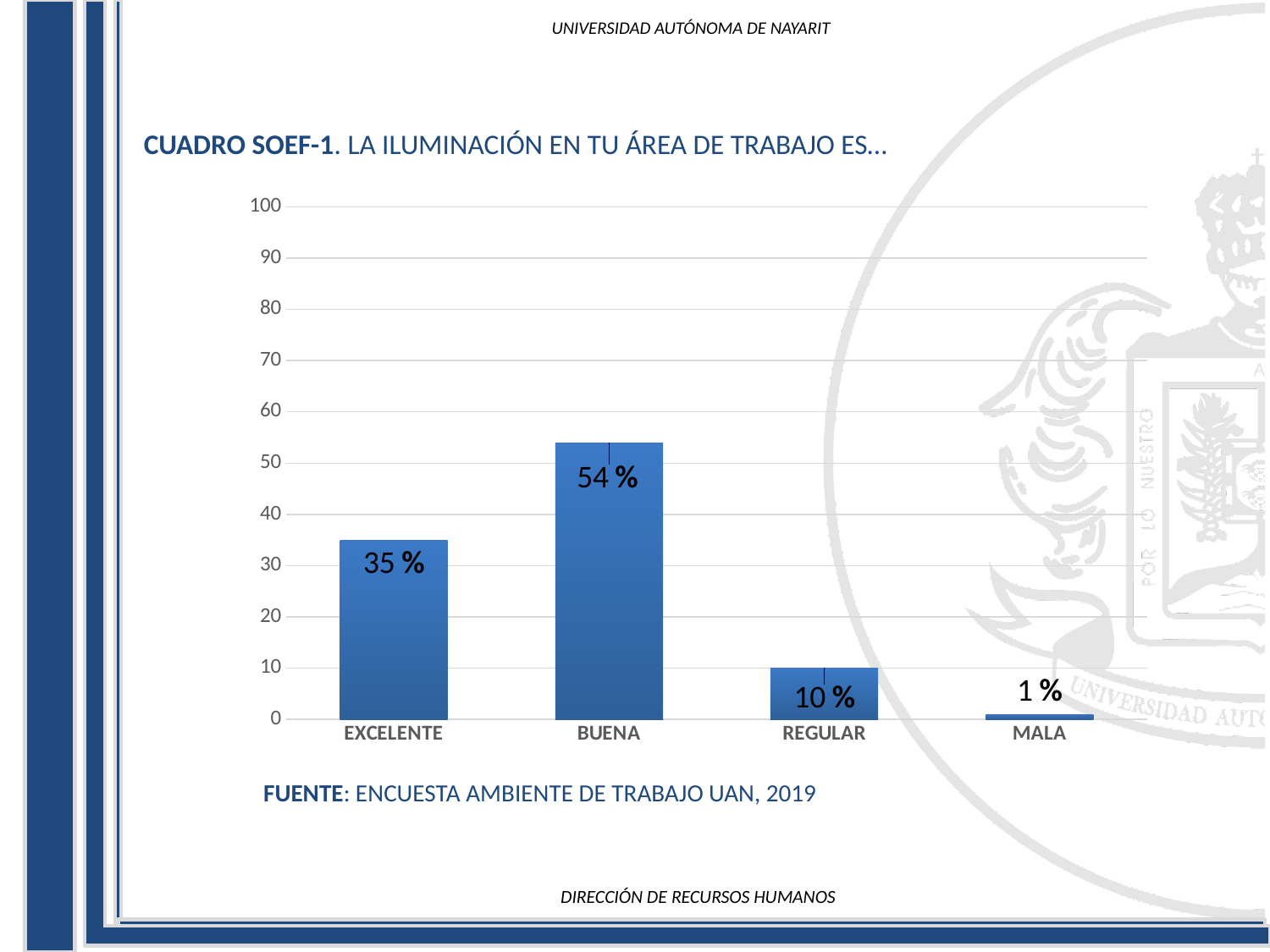
What kind of chart is shown on the slide? Bar chart Which is larger, the value for EXCELENTE or the value for REGULAR? EXCELENTE What is the value for MALA? 1 % Which category has the lowest value? MALA What is the value for EXCELENTE? 35 % What is the title of the chart? CUADRO SOEF-1. LA ILUMINACIÓN EN TU ÁREA DE TRABAJO ES… How many categories are shown on the x axis? 4 What is the difference between the values for BUENA and EXCELENTE? 19 % Which category has the highest value? BUENA What is the difference between the values for REGULAR and MALA? 9 % What is the value for REGULAR? 10 % What is the value for BUENA? 54 %